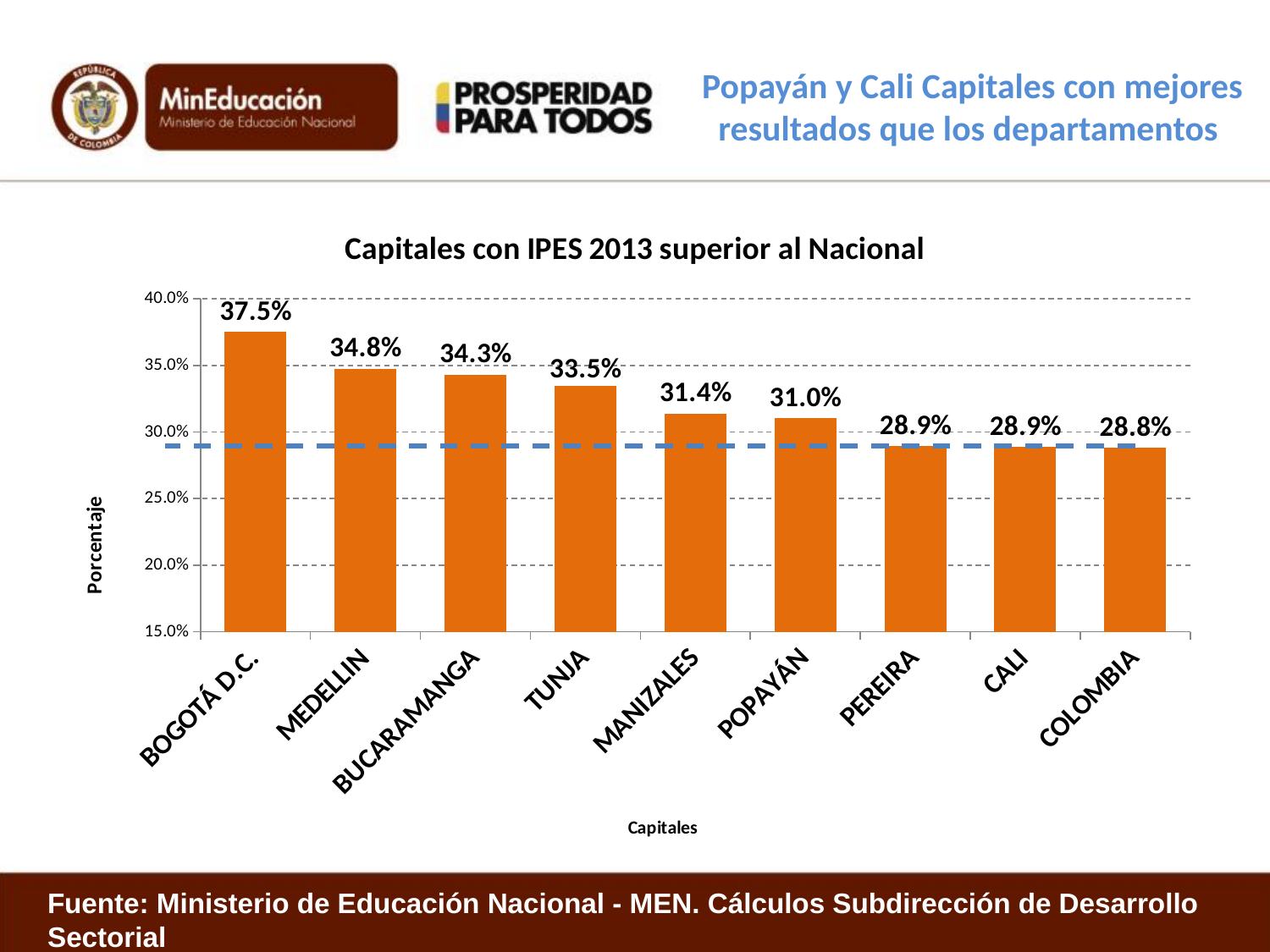
What is the value for COLOMBIA? 28.8% What is the title of the chart? Capitales con IPES 2013 superior al Nacional What kind of chart is shown? Bar chart What is the difference between the values for MANIZALES and POPAYÁN? 0.4% Which category has the lowest value? COLOMBIA Is the value for POPAYÁN greater or less than 30.0%? greater What is the value for TUNJA? 33.5% What is the value for BOGOTÁ D.C.? 37.5% How many categories are shown on the x axis? 9 Which is larger, the value for BUCARAMANGA or the value for MANIZALES? BUCARAMANGA What is the difference between the values for BOGOTÁ D.C. and MEDELLIN? 2.7% Which category has the highest value? BOGOTÁ D.C.